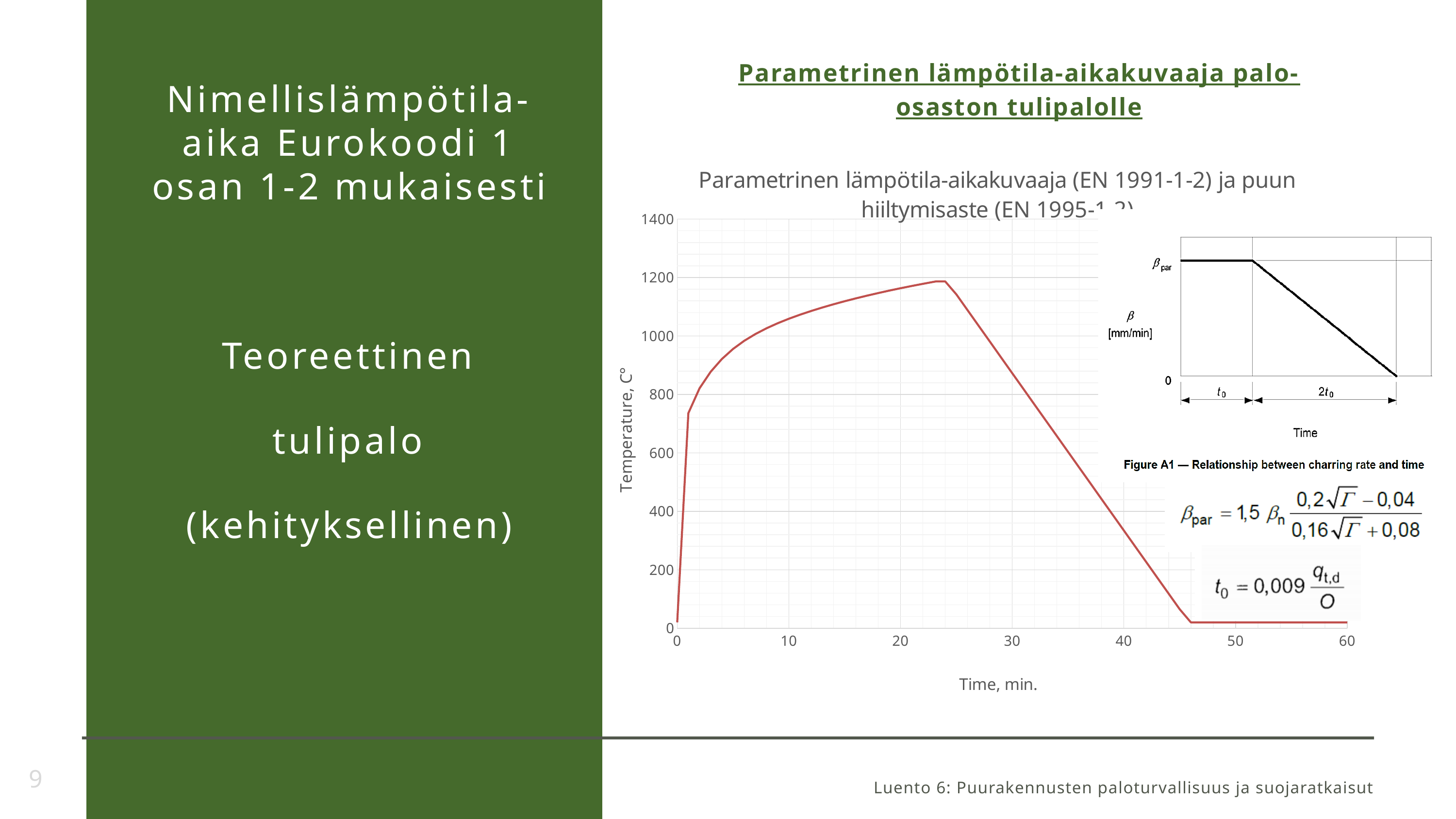
Is the temperature at 30 min greater or less than 800? greater What kind of chart is the temperature-time chart on the slide? line chart What is the label of the x axis of the temperature-time chart? Time, min. Does the temperature rise or fall between 30 and 40 min? fall Does the temperature rise or fall between 0 and 20 min? rise Is the temperature at 20 min greater or less than 1000? greater Is the temperature at 10 min greater or less than 1000? greater Which is higher, the temperature at 10 min or at 40 min? 10 min What is the label of the y axis of the temperature-time chart? Temperature, C°